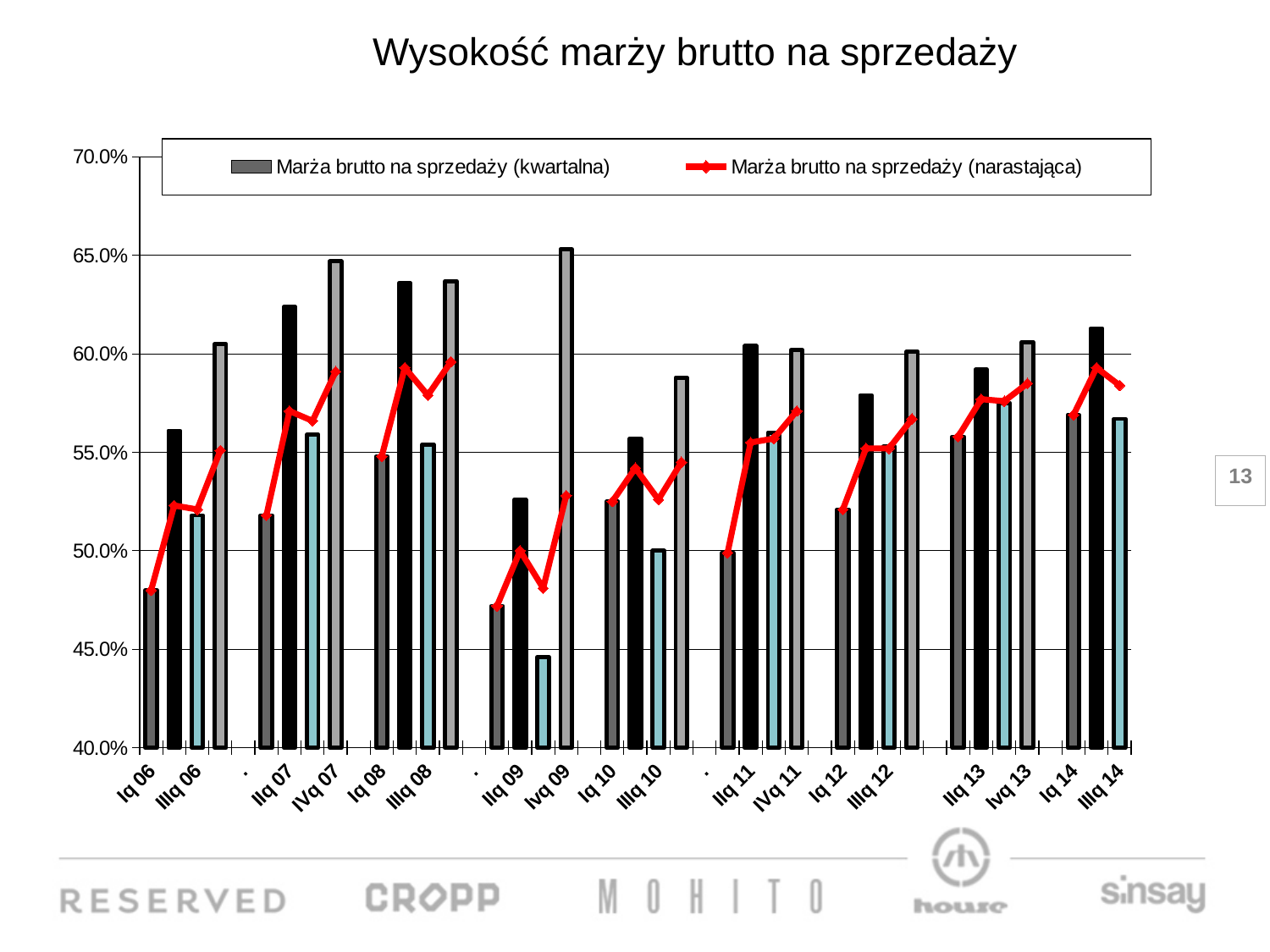
Is the quarterly gross margin bar for Iq 12 greater or less than 55.0%? less What kind of chart is shown on the slide? A combined bar and line chart How many series does the legend list? 2 Is the quarterly gross margin bar for IIq 09 greater or less than 50.0%? greater Which has the larger quarterly gross margin bar, IVq 09 or IIq 09? IVq 09 Is the quarterly gross margin bar for Iq 06 greater or less than 50.0%? less Which series is drawn as a red line with markers? Marża brutto na sprzedaży (narastająca) What is the title of the chart? Wysokość marży brutto na sprzedaży Does the cumulative gross margin line rise or fall from Iq 06 to IVq 07? rise Which labeled quarter has the highest quarterly gross margin bar? Ivq 09